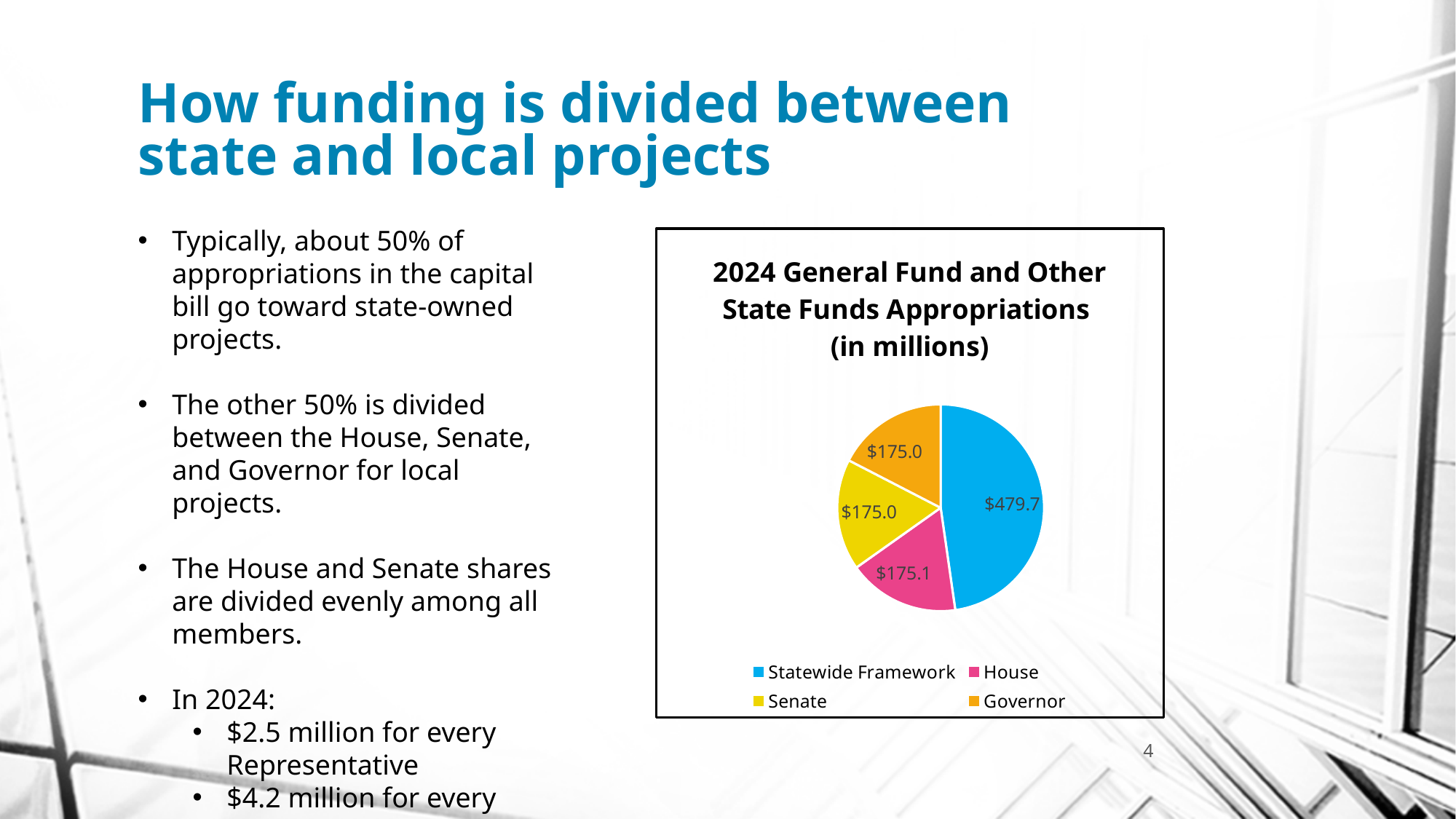
What is the value for Statewide Framework in the pie chart? $479.7 What is the title of the chart? 2024 General Fund and Other State Funds Appropriations (in millions) What is the value for Senate in the pie chart? $175.0 What is the difference between the Statewide Framework value and the House value? $304.6 What is the value for House in the pie chart? $175.1 Which is larger, the Statewide Framework slice or the Governor slice? Statewide Framework How many slices does the pie chart have? 4 What is the value for Governor in the pie chart? $175.0 Which category has the largest slice in the pie chart? Statewide Framework What type of chart is shown on the slide? Pie chart How many entries does the chart legend list? 4 What colour is the Senate slice in the pie chart? Yellow